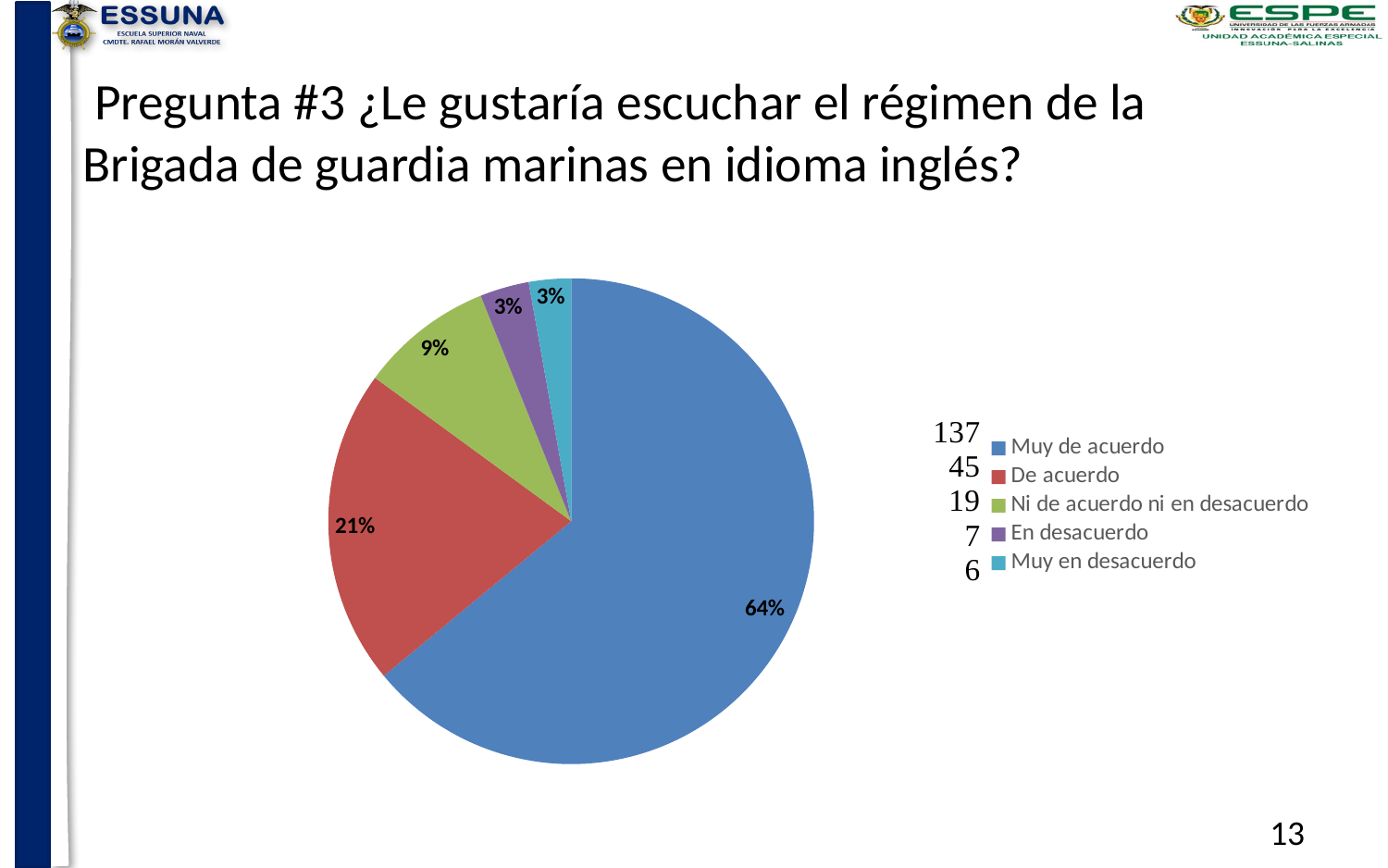
What percentage of the pie corresponds to "En desacuerdo"? 3% What number is shown next to the legend entry "Muy de acuerdo"? 137 Which slice is larger, "De acuerdo" or "Ni de acuerdo ni en desacuerdo"? De acuerdo What colour is the "Muy de acuerdo" slice of the pie? blue How many categories does the legend list? 5 Which category has the largest slice of the pie? Muy de acuerdo What is the difference in percentage points between the "Muy de acuerdo" and "De acuerdo" slices? 43 What percentage of the pie corresponds to "Muy de acuerdo"? 64% What percentage of the pie corresponds to "Ni de acuerdo ni en desacuerdo"? 9% What kind of chart is shown on the slide? pie chart What number is shown next to the legend entry "Muy en desacuerdo"? 6